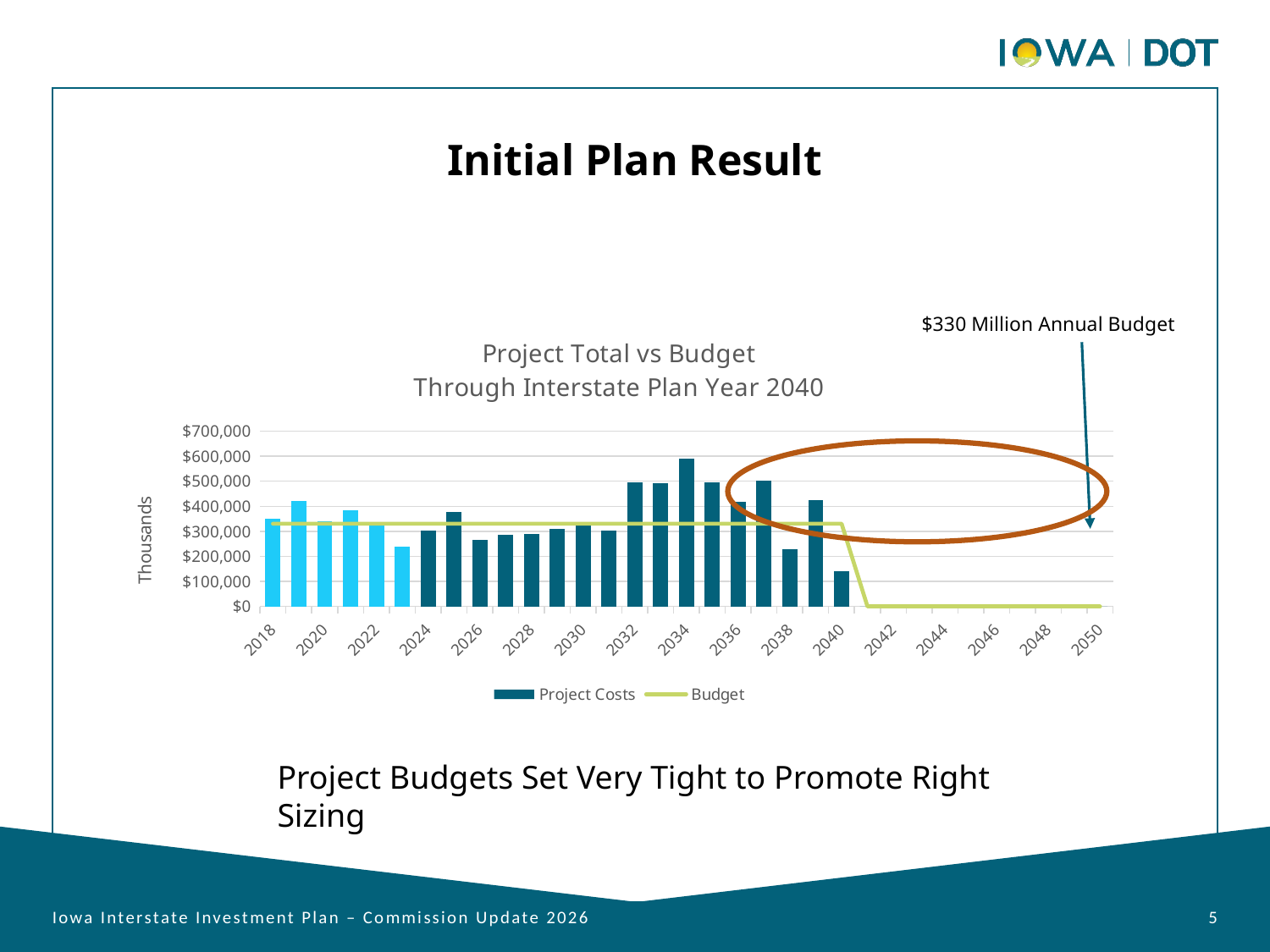
Which year has the larger Project Costs bar, 2038 or 2039? 2039 How many series does the chart legend list? 2 What is the title of the chart? Project Total vs Budget Through Interstate Plan Year 2040 What are the two entries in the chart legend? Project Costs and Budget Which year has the highest Project Costs bar? 2034 Is the Project Costs value for 2037 greater or less than $400,000? greater Is the Project Costs value for 2040 greater or less than $200,000? less Is the Project Costs value for 2023 greater or less than $300,000? less Which year has the lowest Project Costs bar? 2040 What kind of chart is shown on the slide? Bar chart (with a line for Budget) How many Project Costs bars are plotted on the chart? 23